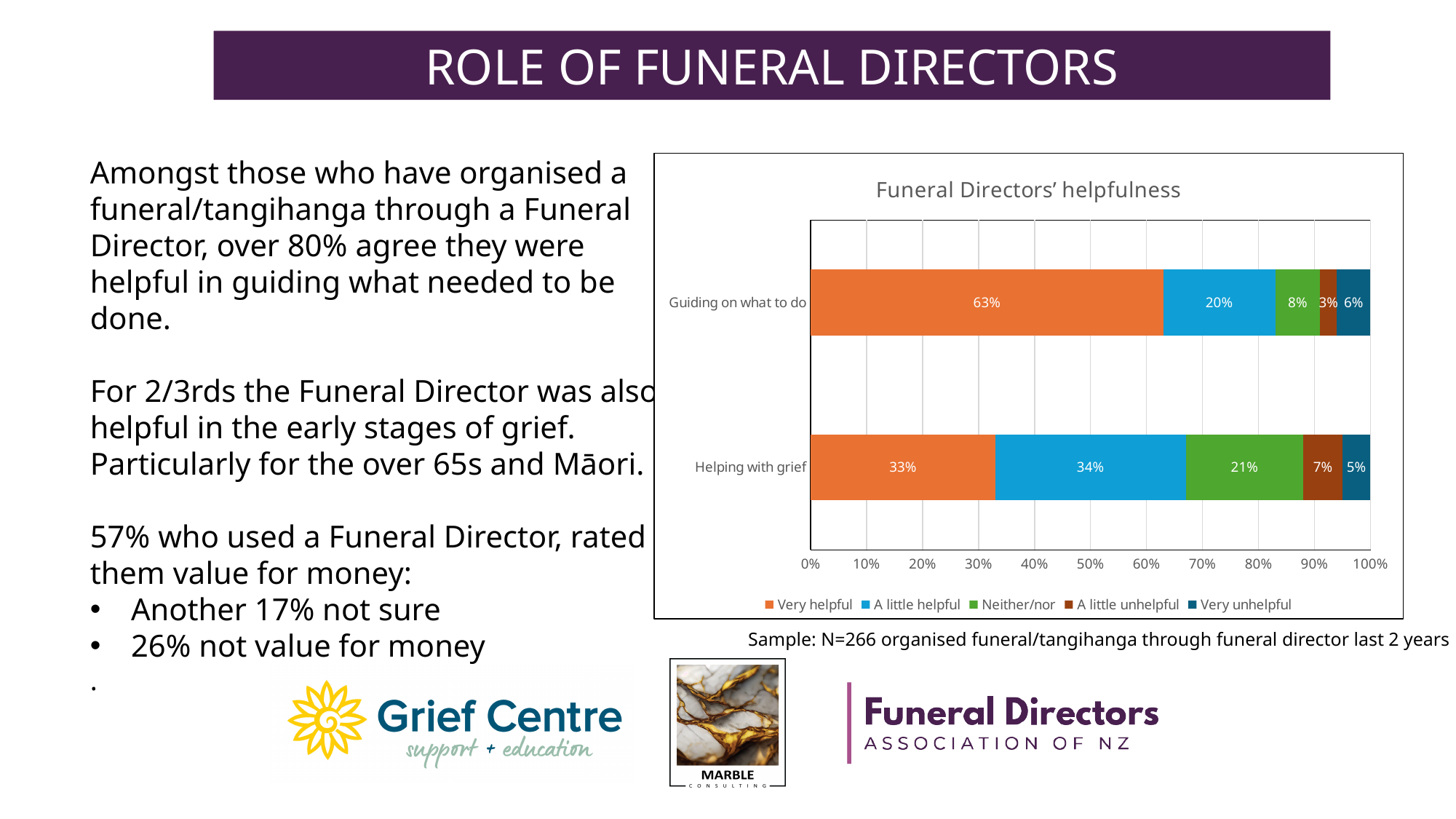
What is the 'Very helpful' value for 'Guiding on what to do'? 63% Which category has the higher 'Very helpful' value? Guiding on what to do What is the 'Neither/nor' value for 'Helping with grief'? 21% How many categories are shown on the chart? 2 What is the combined 'Very helpful' and 'A little helpful' share for 'Helping with grief'? 67% What is the 'Very unhelpful' value for 'Guiding on what to do'? 6% What kind of chart is shown on the slide? Stacked bar chart What is the title of the chart? Funeral Directors' helpfulness What is the difference between the 'Very helpful' values for 'Guiding on what to do' and 'Helping with grief'? 30% Is the 'A little unhelpful' value larger for 'Helping with grief' or 'Guiding on what to do'? Helping with grief How many series does the legend list? 5 What is the 'A little helpful' value for 'Helping with grief'? 34%